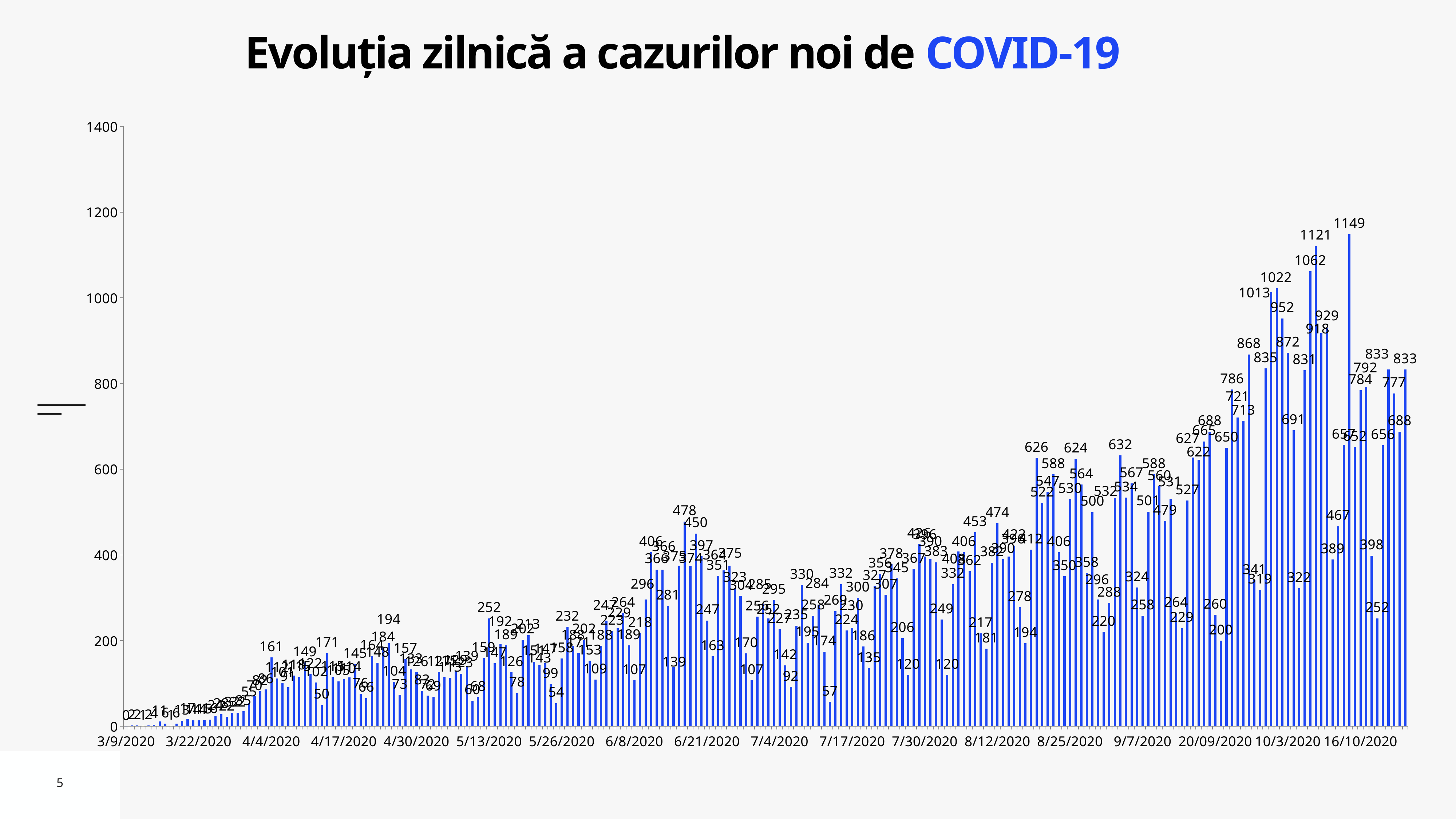
Is the tallest bar on the chart greater or less than 1000? greater What kind of chart is shown on the slide? bar chart Which is larger, the bar labeled 1062 or the bar labeled 1149? 1149 What is the second-highest value labeled on the chart? 1121 What is the value of the last bar on the right of the chart? 833 What is the highest value labeled on the chart? 1149 Overall, do the values rise or fall from left to right along the x axis? rise Is the tallest bar on the chart greater or less than 1200? less What is the maximum value shown on the y axis? 1400 What is the title of the chart? Evoluția zilnică a cazurilor noi de COVID-19 What is the difference between the two highest labeled values, 1149 and 1121? 28 Which is larger, the bar labeled 1013 or the bar labeled 1022? 1022